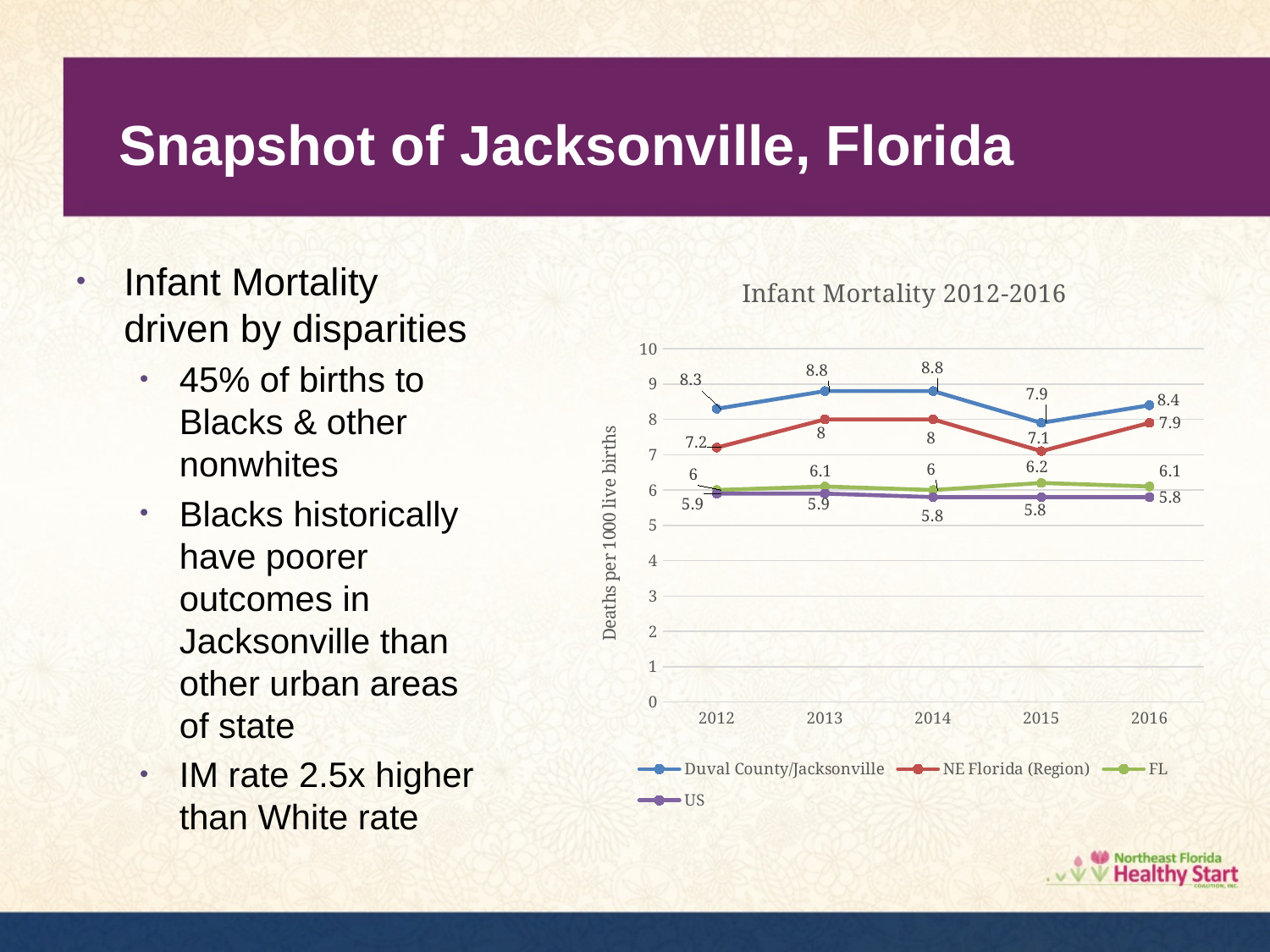
In which year is the Duval County/Jacksonville rate lowest? 2015 What is the value for the US in 2016? 5.8 Which series has the higher value in 2012, NE Florida (Region) or FL? NE Florida (Region) What is the label of the y axis on the chart? Deaths per 1000 live births What is the difference between the Duval County/Jacksonville rate and the US rate in 2014? 3 What is the title of the chart? Infant Mortality 2012-2016 In which year is the FL rate highest? 2015 What is the infant mortality rate for Duval County/Jacksonville in 2013? 8.8 How many years are plotted along the x axis of the chart? 5 What type of chart is shown on the slide? line chart What is the value for NE Florida (Region) in 2015? 7.1 How many series does the chart legend list? 4